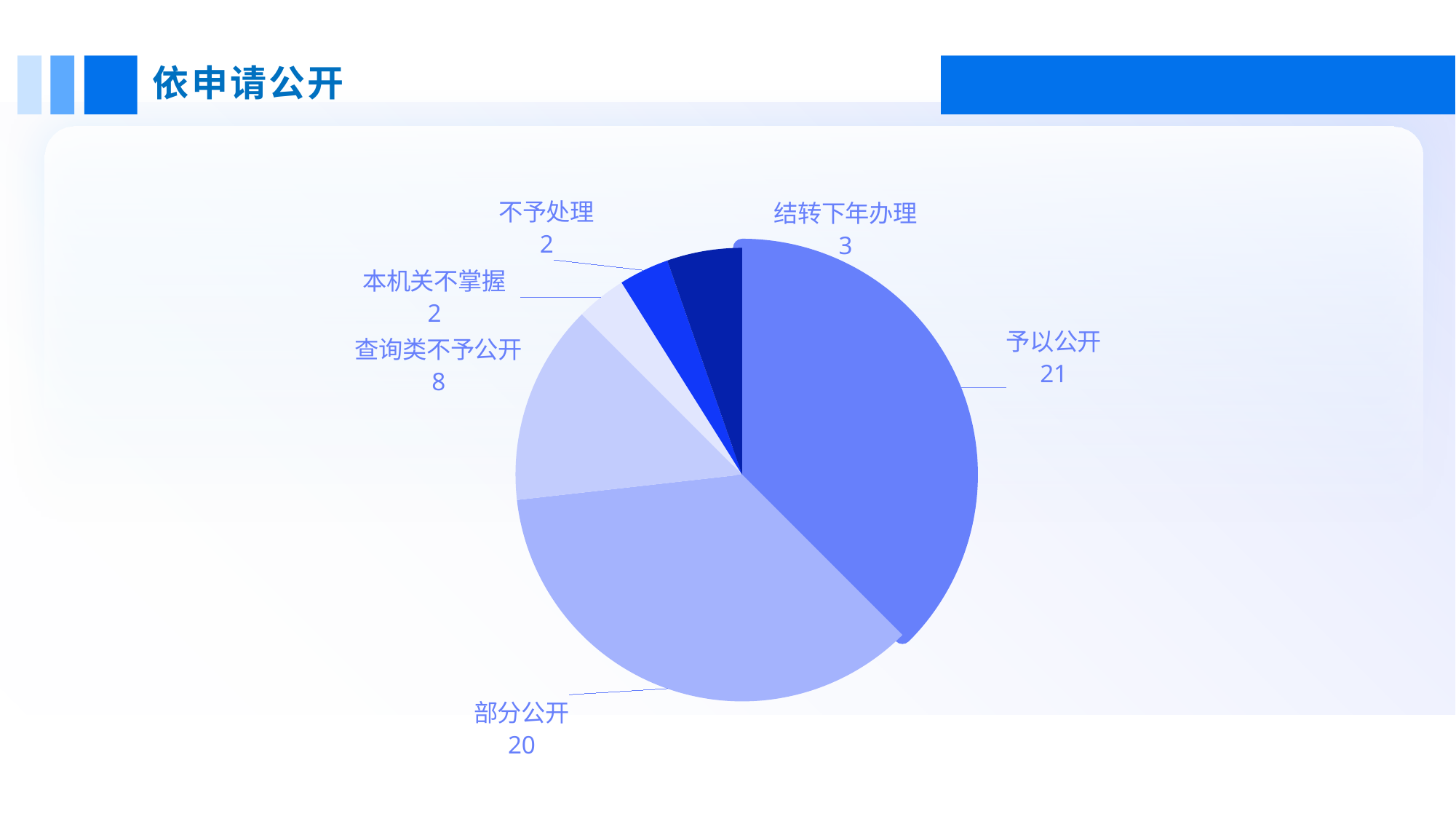
How many categories does the pie chart show? 6 What is the title of the slide containing the chart? 依申请公开 What is the difference between the values for 查询类不予公开 and 结转下年办理? 5 What is the value for 予以公开? 21 What is the value for 部分公开? 20 What is the difference between the values for 予以公开 and 部分公开? 1 What kind of chart is shown on the slide? pie chart What is the value for 查询类不予公开? 8 What is the total of all the slices in the pie chart? 56 Which category has the largest slice? 予以公开 What is the value for 结转下年办理? 3 Which is larger, the value for 查询类不予公开 or the value for 结转下年办理? 查询类不予公开